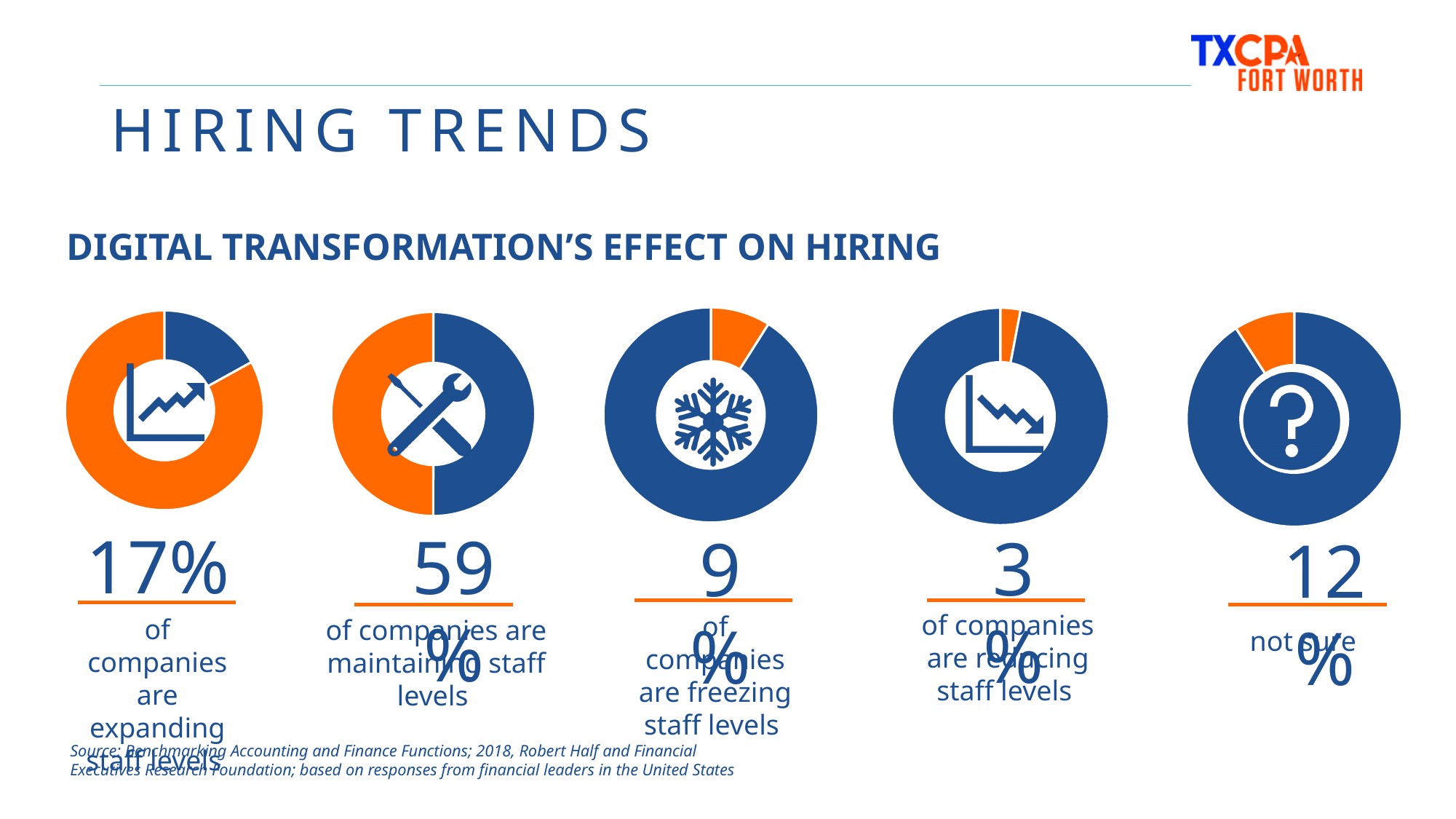
What percentage of companies are maintaining staff levels? 59% What type of chart is used to show each hiring statistic on the slide? Donut (pie) chart What percentage of companies are reducing staff levels? 3% How many donut charts are shown on the slide? 5 What is the heading above the donut charts? Digital Transformation's Effect on Hiring What percentage of companies are freezing staff levels? 9% Which response has the highest percentage among the five donut charts? Maintaining staff levels Which is larger: the percentage of companies freezing staff levels or the percentage that are not sure? Not sure What is the difference in percentage points between companies maintaining staff levels and companies expanding staff levels? 42 What percentage of companies are expanding staff levels? 17% Which response has the lowest percentage among the five donut charts? Reducing staff levels What percentage of respondents are not sure about digital transformation's effect on hiring? 12%